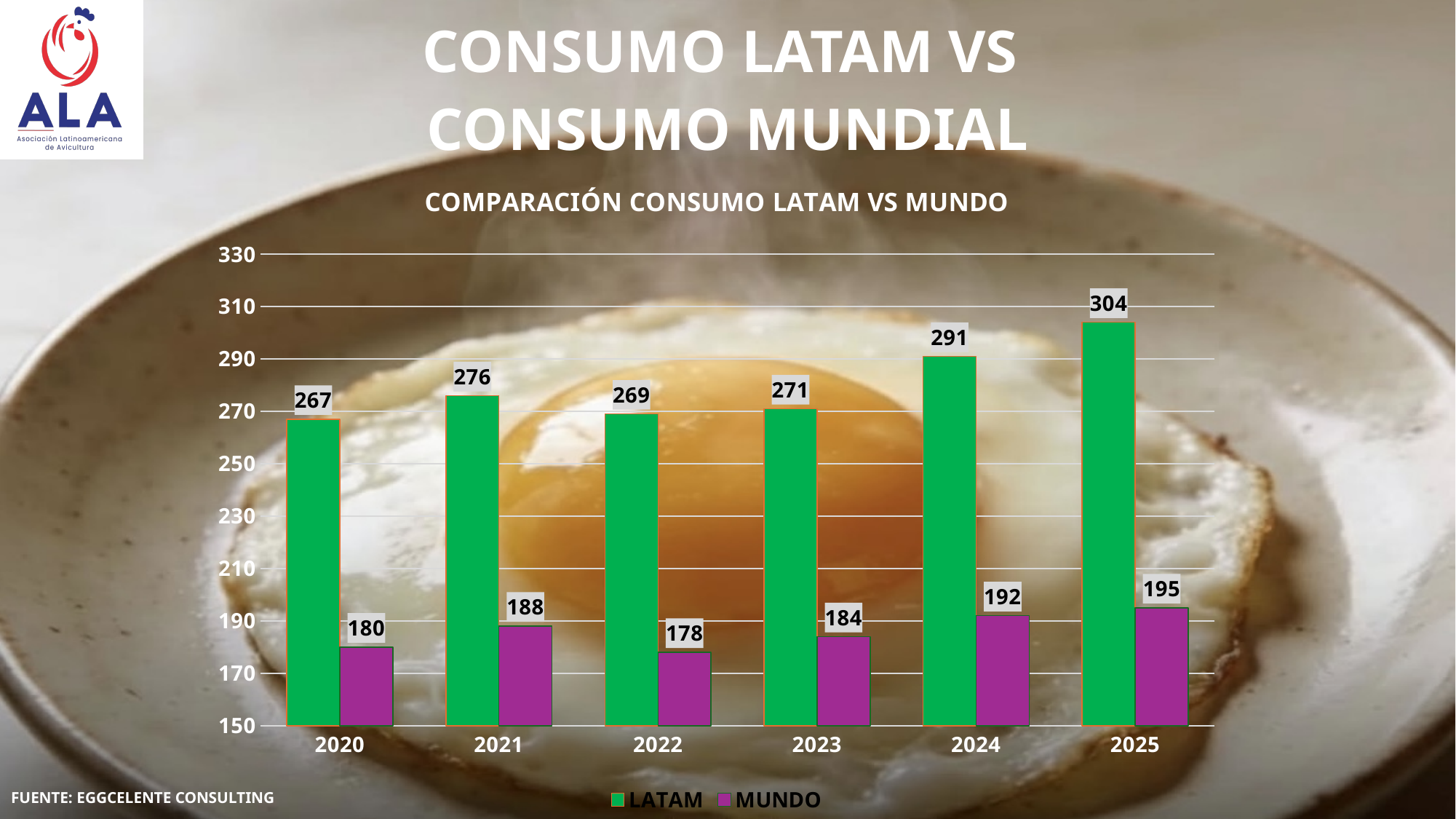
Which is larger, the LATAM value for 2021 or the LATAM value for 2023? LATAM 2021 What kind of chart is shown? bar chart What is the LATAM value for 2025? 304 What is the MUNDO value for 2022? 178 How many series does the legend list? 2 Which year has the highest LATAM value? 2025 How many years are shown on the x axis? 6 What is the LATAM value for 2020? 267 What is the difference between the LATAM and MUNDO values in 2024? 99 Which year has the lowest MUNDO value? 2022 Is the MUNDO value for 2025 greater or less than 190? greater What is the title of the chart? COMPARACIÓN CONSUMO LATAM VS MUNDO